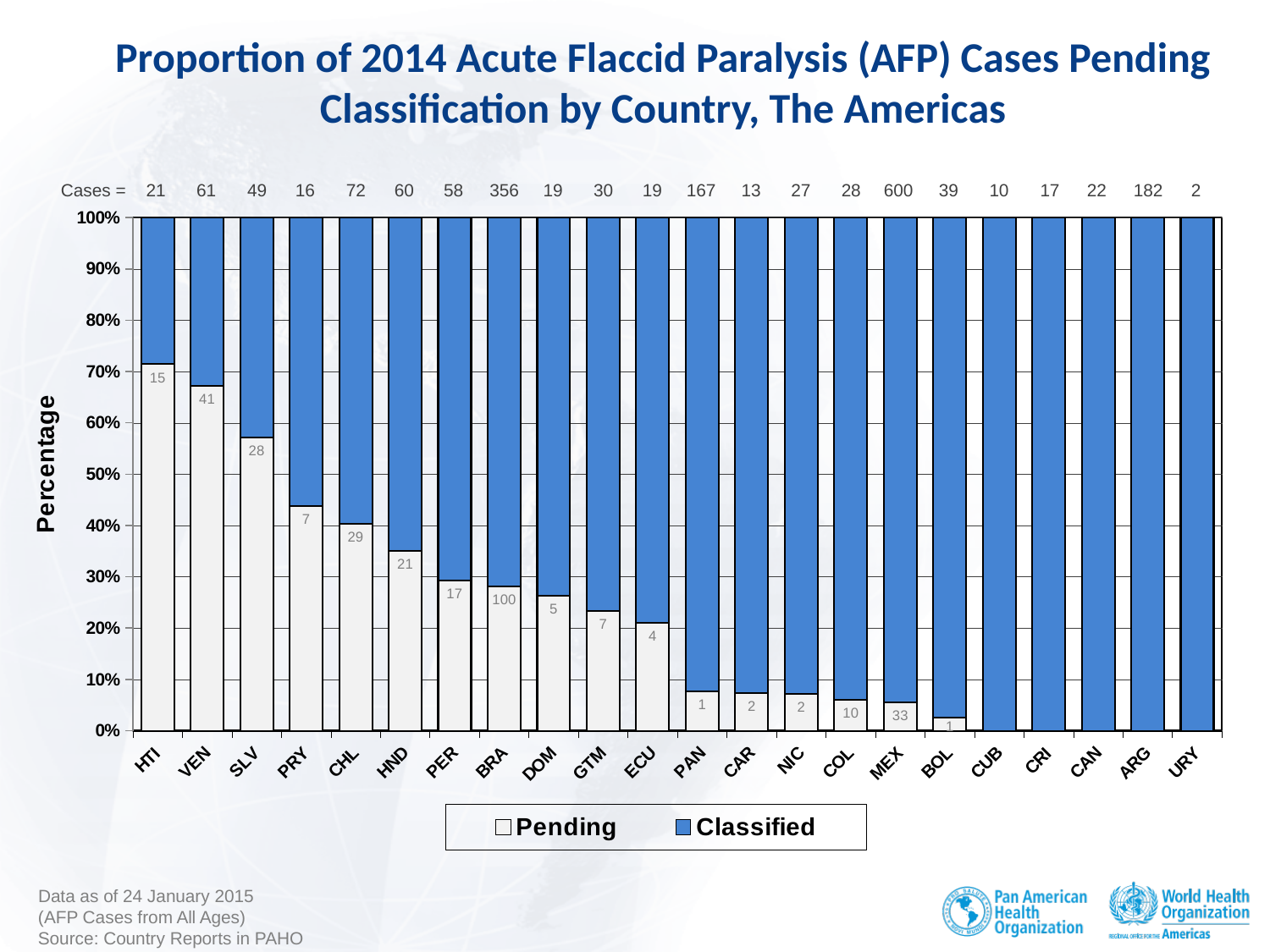
What is the number of pending cases labelled on the bar for VEN? 41 Which country has the largest labelled number of pending cases? BRA Which has a larger pending share of cases, SLV or CHL? SLV According to the 'Cases =' row, how many AFP cases does MEX have? 600 Is the pending percentage for HTI greater or less than 70%? greater How many countries are shown along the x axis of the chart? 22 Is the pending percentage for PRY greater or less than 50%? less What is the number of pending cases labelled on the bar for BRA? 100 How many series does the legend list? 2 What type of chart is shown on the slide? stacked bar chart Does the pending share of cases rise or fall moving from left to right along the x axis? fall According to the 'Cases =' row, how many AFP cases does URY have? 2